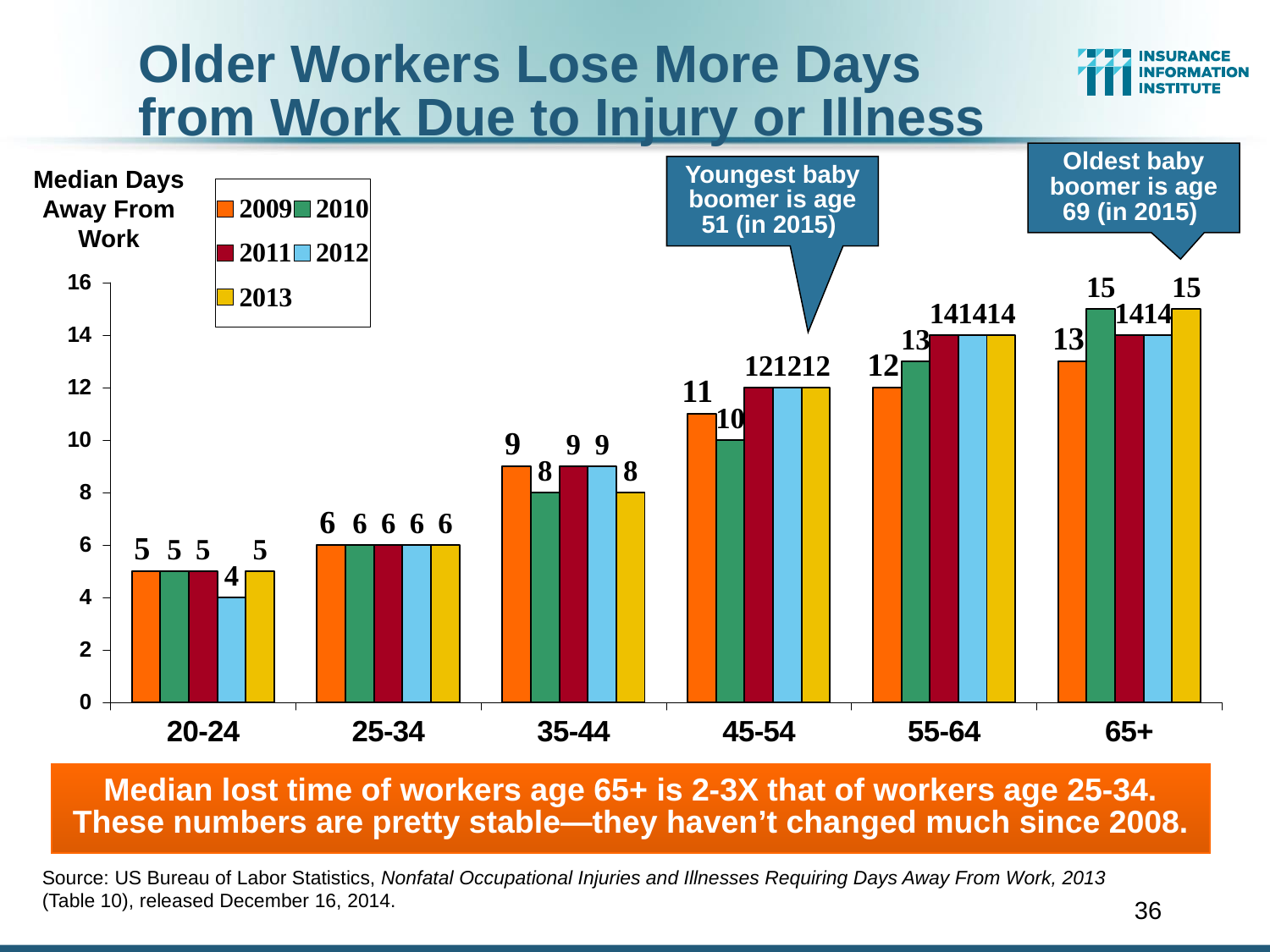
What is the median days away from work for the 65+ age group in 2010? 15 What is the median days away from work for the 20-24 age group in 2012? 4 Which age group has the highest median days away from work in 2013? 65+ Which age group has the lowest median days away from work in 2009? 20-24 What is the median days away from work for the 55-64 age group in 2013? 14 What is the median days away from work for the 45-54 age group in 2009? 11 Do the 2013 values rise or fall as age group increases along the x axis? Rise How many age groups are shown on the x axis? 6 What kind of chart is shown on the slide? Bar chart How many series does the legend list? 5 In 2010, which age group has a higher median days away from work, 35-44 or 45-54? 45-54 What is the difference in median days away from work between the 65+ and 25-34 age groups in 2013? 9